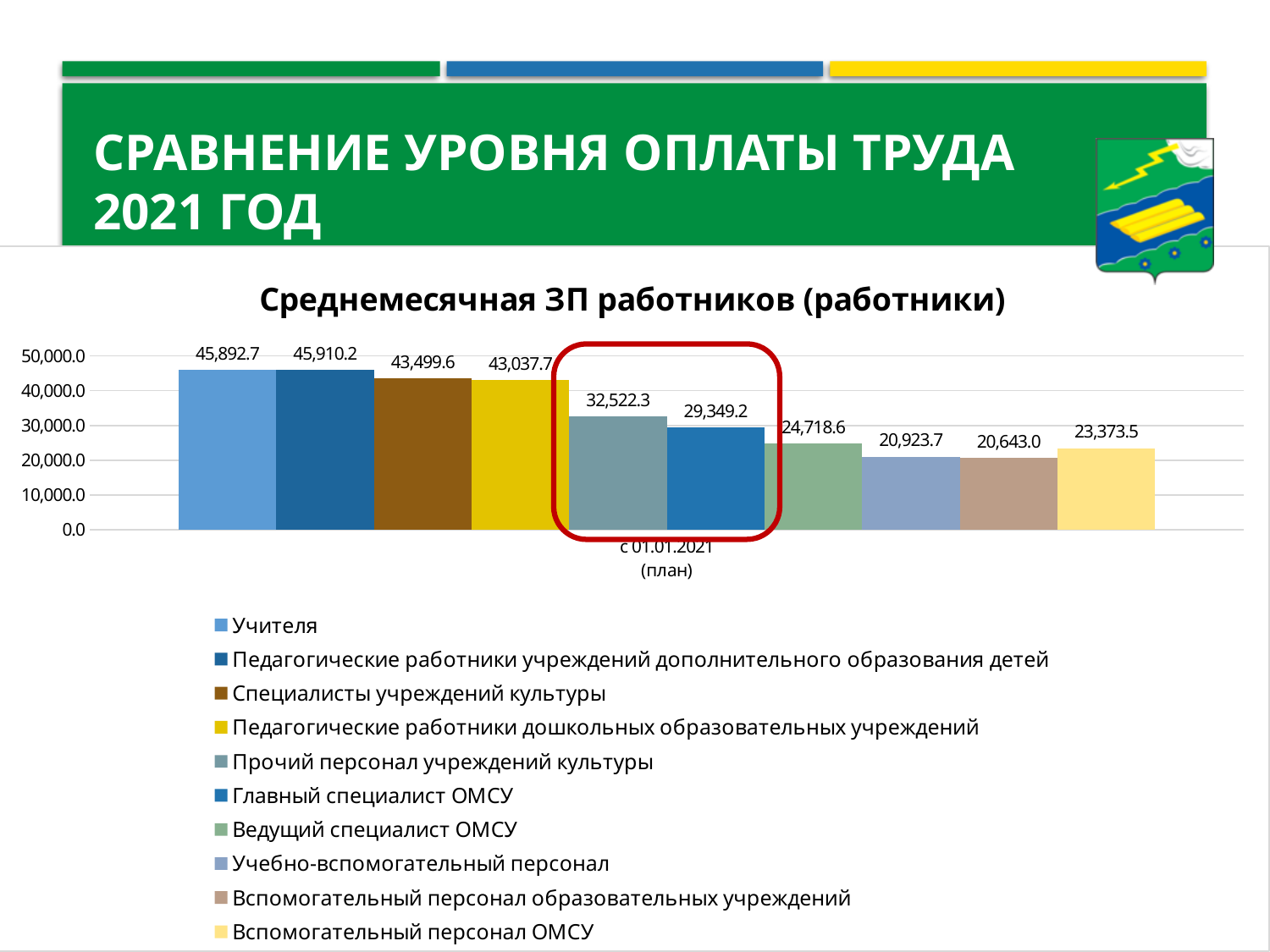
What is the difference between the values for Ведущий специалист ОМСУ and Вспомогательный персонал ОМСУ? 1,345.1 Which series has the highest value in the chart? Педагогические работники учреждений дополнительного образования детей What value is shown for Главный специалист ОМСУ? 29,349.2 What value is shown for Вспомогательный персонал ОМСУ? 23,373.5 Which series has the lowest value in the chart? Вспомогательный персонал образовательных учреждений What kind of chart is shown on the slide? Bar chart What is the average monthly salary shown for Учителя? 45,892.7 How many series does the legend list? 10 What value is shown for Прочий персонал учреждений культуры? 32,522.3 What is the title of the chart? Среднемесячная ЗП работников (работники) Which is larger: the value for Специалисты учреждений культуры or for Педагогические работники дошкольных образовательных учреждений? Специалисты учреждений культуры What is the difference between the values for Прочий персонал учреждений культуры and Главный специалист ОМСУ? 3,173.1